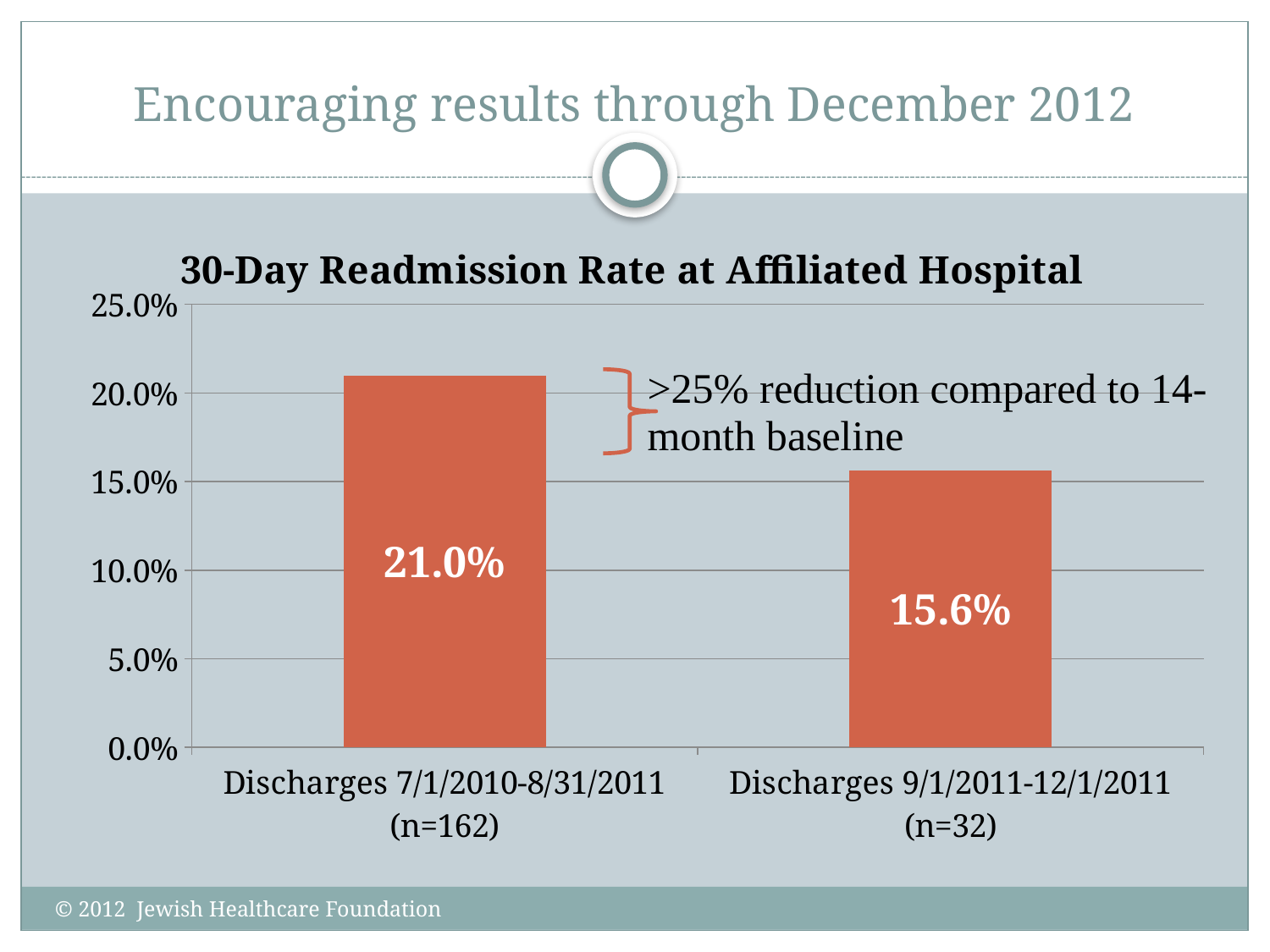
Is the readmission rate for Discharges 9/1/2011-12/1/2011 greater or less than 20.0%? less What is the 30-day readmission rate for Discharges 9/1/2011-12/1/2011 (n=32)? 15.6% What is the difference in readmission rate between the 7/1/2010-8/31/2011 period and the 9/1/2011-12/1/2011 period? 5.4% What kind of chart is shown on the slide? Bar chart What is the highest value shown on the chart's vertical axis? 25.0% What is the title of the chart? 30-Day Readmission Rate at Affiliated Hospital Which discharge period has the higher readmission rate? Discharges 7/1/2010-8/31/2011 (n=162) Is the readmission rate for Discharges 7/1/2010-8/31/2011 greater or less than 20.0%? greater What is the 30-day readmission rate for Discharges 7/1/2010-8/31/2011 (n=162)? 21.0% How many discharge periods are shown in the chart? 2 Does the readmission rate rise or fall from the earlier discharge period to the later one? Fall Which discharge period has the lower readmission rate? Discharges 9/1/2011-12/1/2011 (n=32)